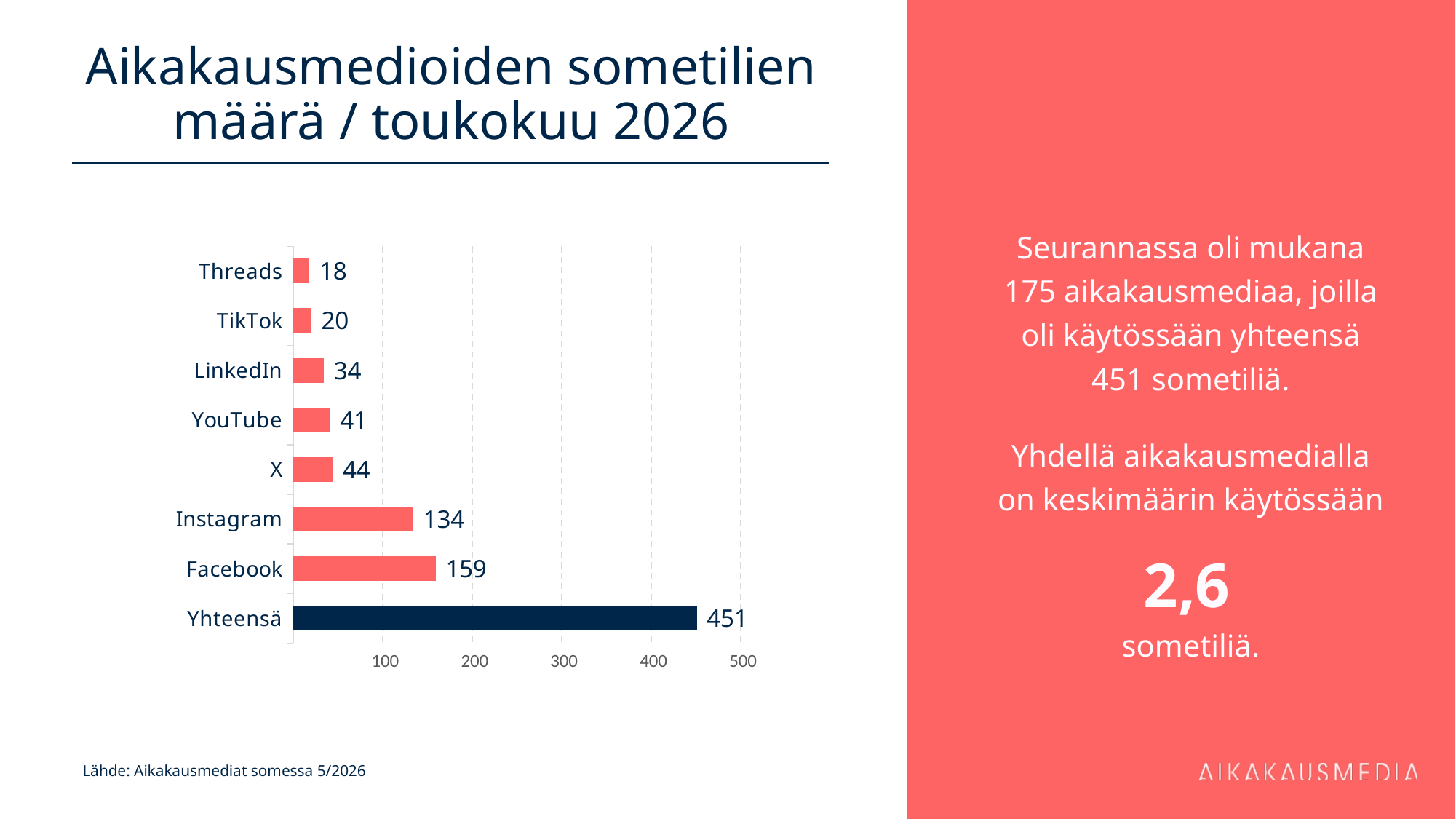
Which individual platform (excluding Yhteensä) has the highest value? Facebook What is the value for Instagram? 134 What is the difference between the values for Facebook and Instagram? 25 Is the value for Yhteensä greater or less than 400? greater What is the value for LinkedIn? 34 What is the title of the slide containing the chart? Aikakausmedioiden sometilien määrä / toukokuu 2026 What kind of chart is shown on the slide? bar chart What is the value for Threads? 18 How many categories are shown on the chart? 8 What is the value for Facebook? 159 Which is larger, the value for X or the value for YouTube? X Which category has the lowest value? Threads